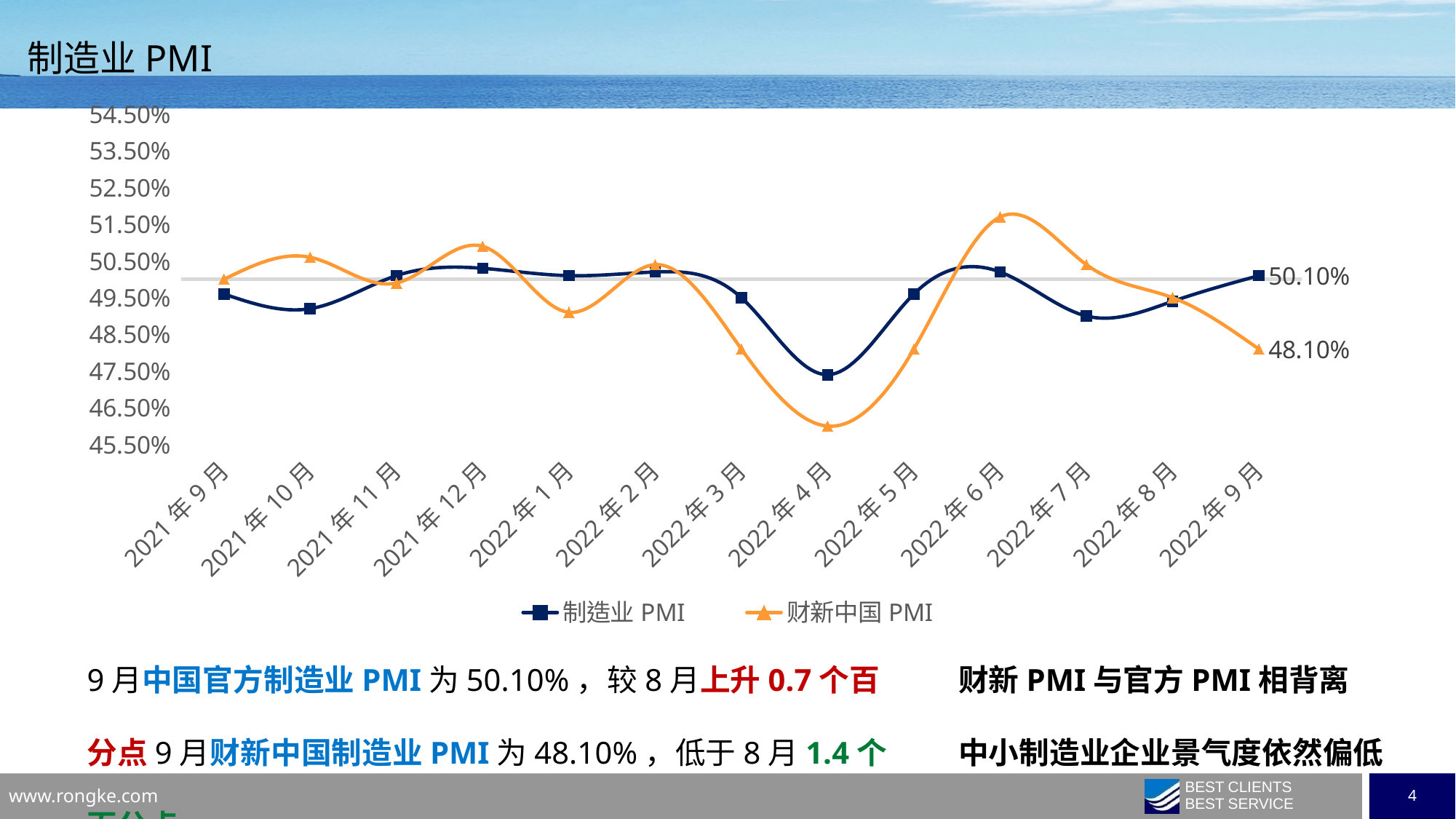
How many months are plotted along the x axis? 13 What kind of chart is shown on the slide? Line chart What is the difference between 制造业 PMI and 财新中国 PMI in 2022年9月? 2.00 percentage points Is the value for 财新中国 PMI in 2022年4月 greater or less than 46.50%? less What is the value of 制造业 PMI for 2022年9月? 50.10% What is the value of 财新中国 PMI for 2022年9月? 48.10% Is the value for 制造业 PMI in 2022年4月 greater or less than 48.50%? less Does 财新中国 PMI rise or fall from 2022年6月 to 2022年9月? fall In which month does 财新中国 PMI reach its lowest value? 2022年4月 In 2022年9月, which series has the higher value, 制造业 PMI or 财新中国 PMI? 制造业 PMI In which month does 财新中国 PMI reach its highest value? 2022年6月 How many series does the legend list? 2